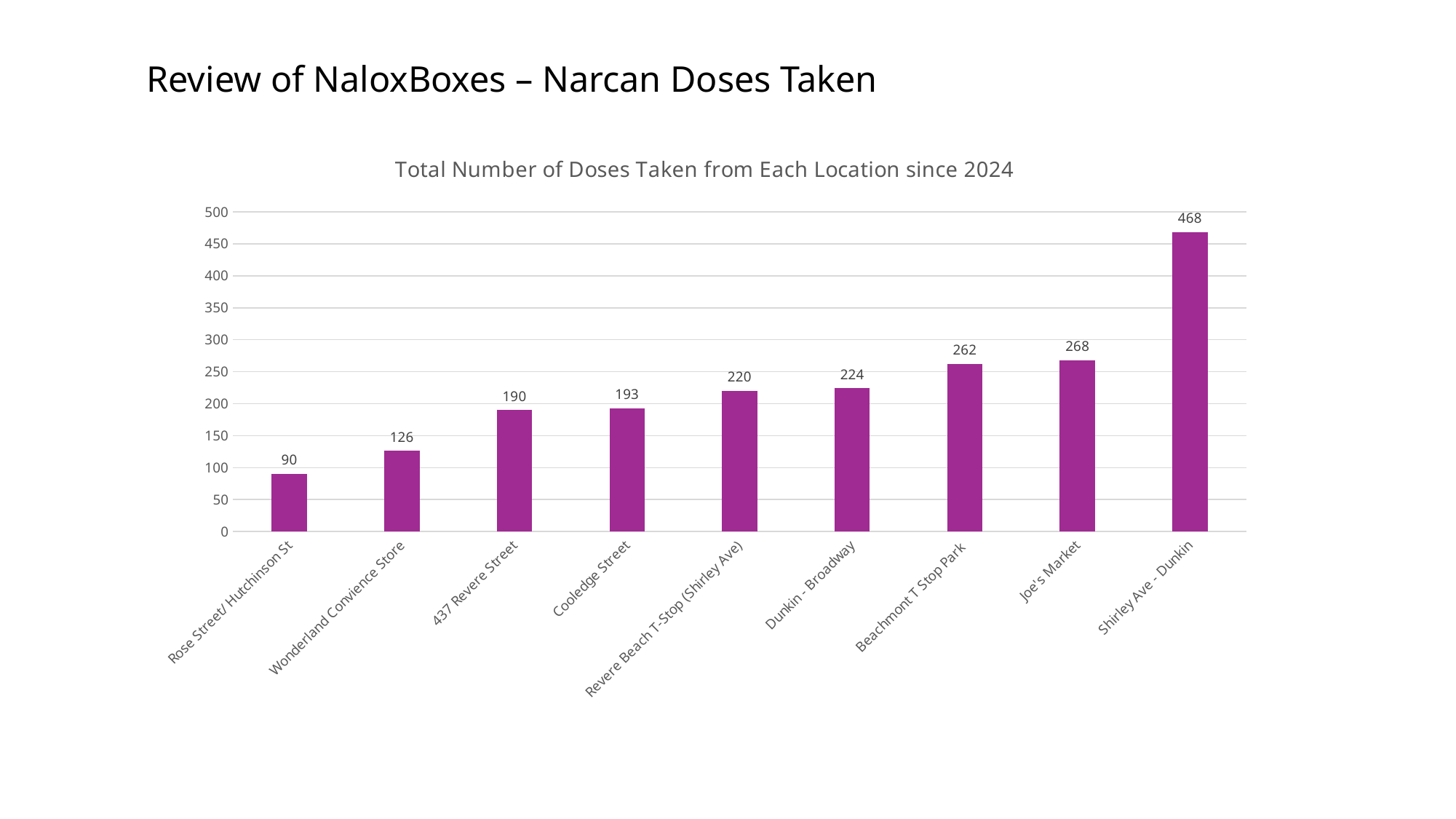
How many doses were taken from Shirley Ave - Dunkin? 468 How many doses were taken from Wonderland Convience Store? 126 How many locations are shown in the chart? 9 What kind of chart is shown on the slide? Bar chart Is the value for Cooledge Street greater or less than 150? greater Which location has the lowest number of doses taken? Rose Street/ Hutchinson St What is the title of the chart? Total Number of Doses Taken from Each Location since 2024 What is the difference in doses taken between Dunkin - Broadway and Revere Beach T-Stop (Shirley Ave)? 4 Which location had more doses taken, 437 Revere Street or Rose Street/ Hutchinson St? 437 Revere Street How many doses were taken from Beachmont T Stop Park? 262 What is the difference in doses taken between Shirley Ave - Dunkin and Joe's Market? 200 Which location has the highest number of doses taken? Shirley Ave - Dunkin